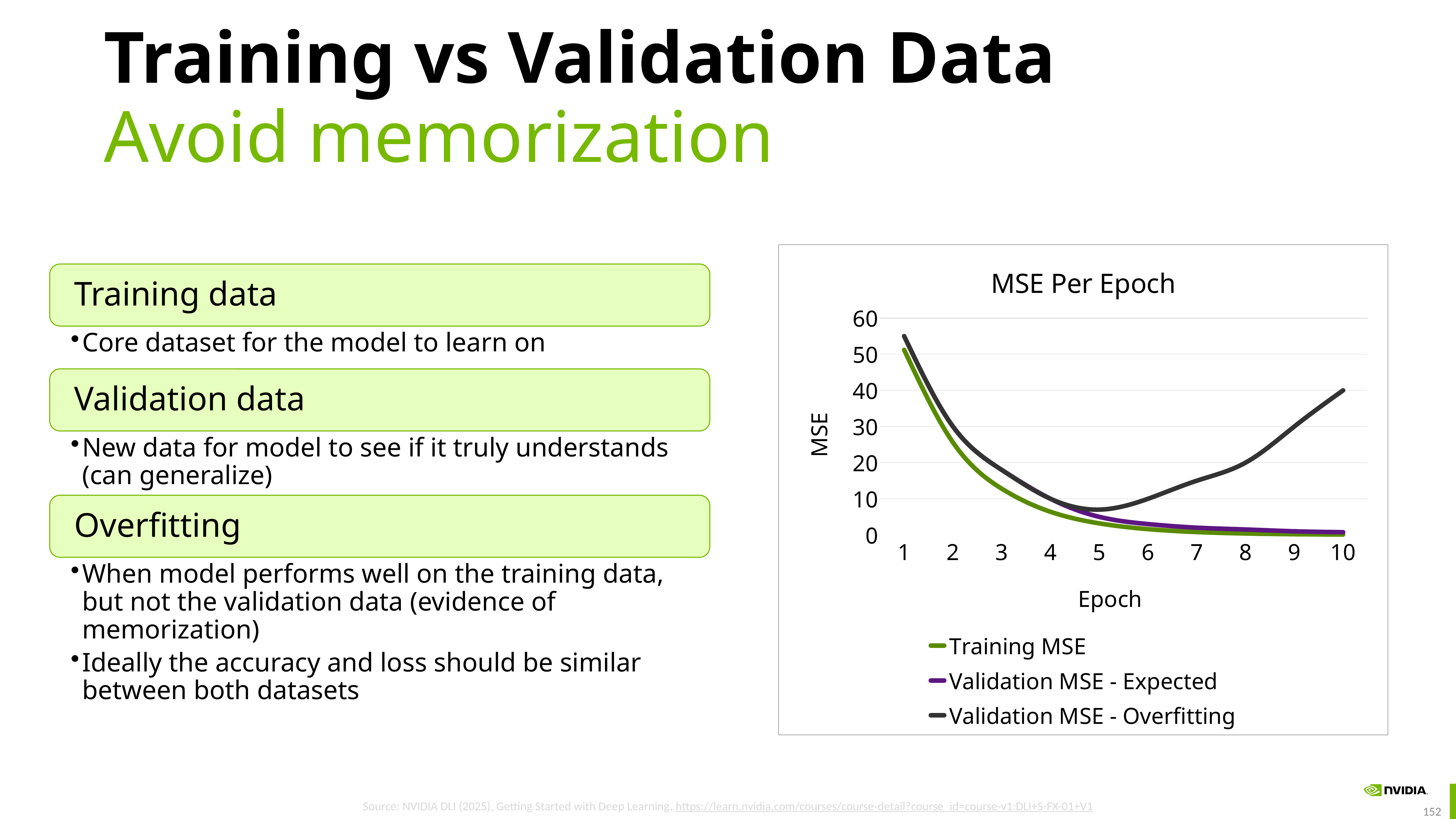
Is the value of Validation MSE - Overfitting at epoch 10 greater or less than 30? greater What is the label of the y axis of the chart? MSE Does the Validation MSE - Overfitting line rise or fall between epoch 5 and epoch 10? Rise Is the value of Training MSE at epoch 10 greater or less than 10? less How many epochs are shown on the x axis of the MSE Per Epoch chart? 10 What is the title of the chart? MSE Per Epoch What kind of chart is shown on the slide? Line chart Does the Training MSE line rise or fall as the epoch increases? Fall How many series does the legend of the MSE Per Epoch chart list? 3 Which series has the highest value at epoch 10? Validation MSE - Overfitting At epoch 10, which is larger: Training MSE or Validation MSE - Overfitting? Validation MSE - Overfitting Is the value of Training MSE at epoch 1 greater or less than 40? greater